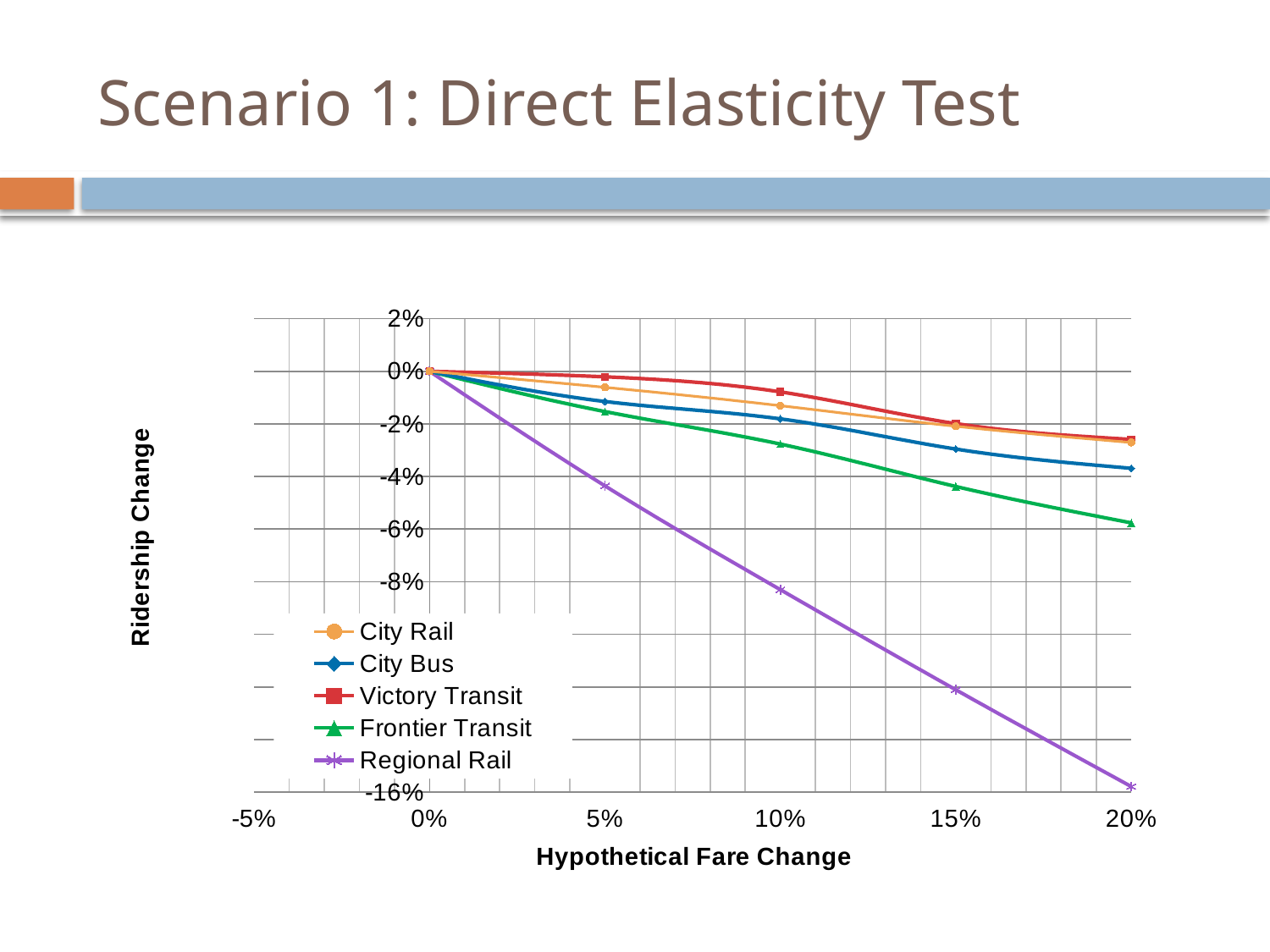
How many series does the legend list? 5 Which series has the highest ridership change at a 10% fare change? Victory Transit How many fare-change points are plotted for each series (from 0% to 20%)? 5 Does the ridership change for Regional Rail rise or fall as the hypothetical fare change increases? fall What is the ridership change for City Bus at a 0% fare change? 0% Is the ridership change for City Bus at a 20% fare change greater or less than -6%? greater Which series has the lowest ridership change at a 20% fare change? Regional Rail Is the ridership change for Regional Rail at a 15% fare change greater or less than -10%? less At a 15% fare change, which is larger: the ridership change for City Bus or for Frontier Transit? City Bus What is the title of the x axis? Hypothetical Fare Change Is the ridership change for Frontier Transit at a 20% fare change greater or less than -4%? less What kind of chart is shown on the slide? line chart